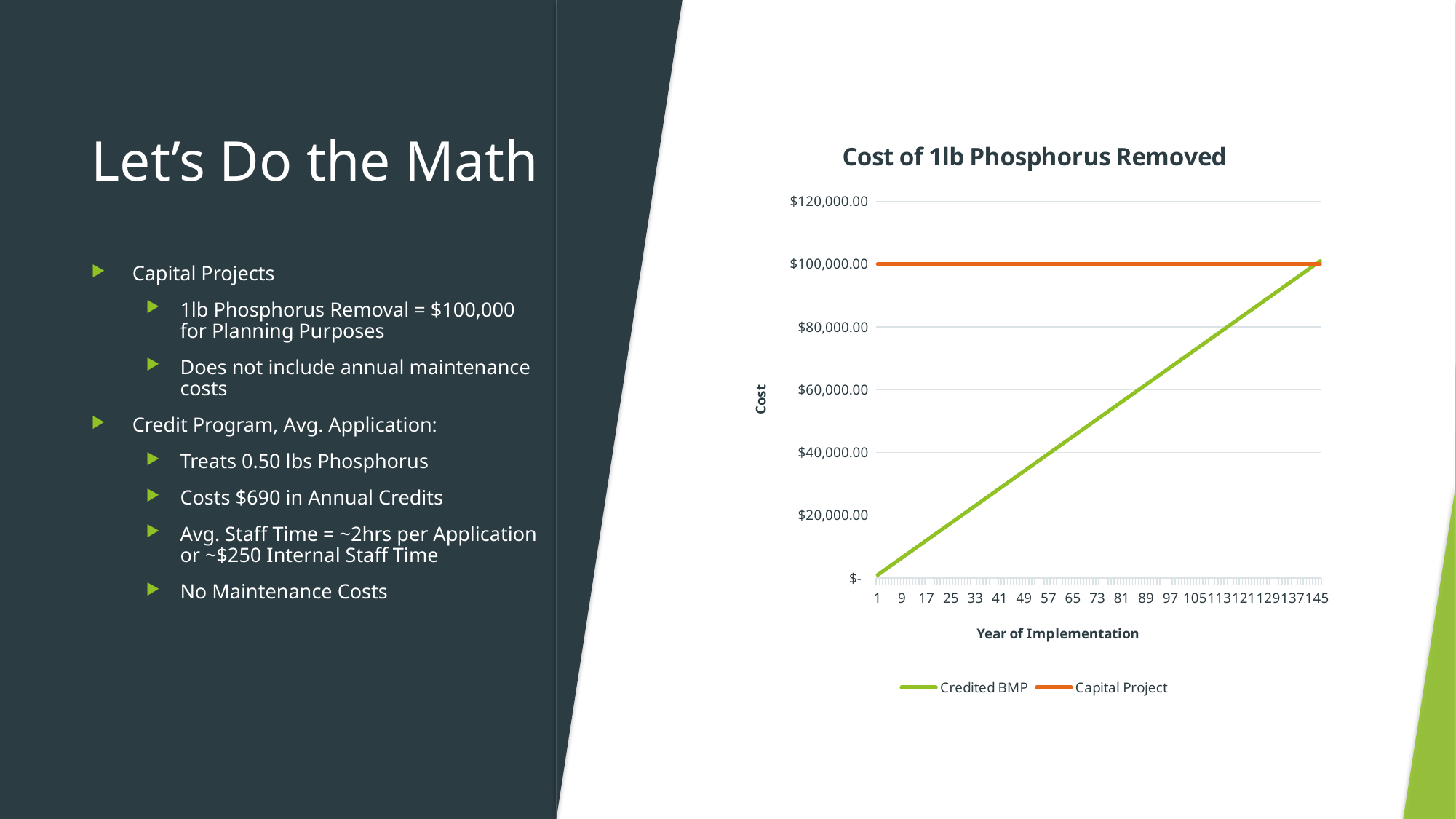
Is the value for Credited BMP at year 105 greater or less than $60,000.00? greater What is the value of the Capital Project series at year 145? $100,000.00 Does the Capital Project series rise, fall, or stay flat across the years of implementation? stay flat What is the title of the chart? Cost of 1lb Phosphorus Removed Does the Credited BMP series rise or fall as the year of implementation increases? rise How many series does the chart's legend list? 2 At year 73, which series has the larger value, Credited BMP or Capital Project? Capital Project What is the label of the chart's horizontal axis? Year of Implementation Is the value for Credited BMP at year 25 greater or less than $20,000.00? less Is the value for Credited BMP at year 73 greater or less than $40,000.00? greater What kind of chart is shown on the slide? line chart